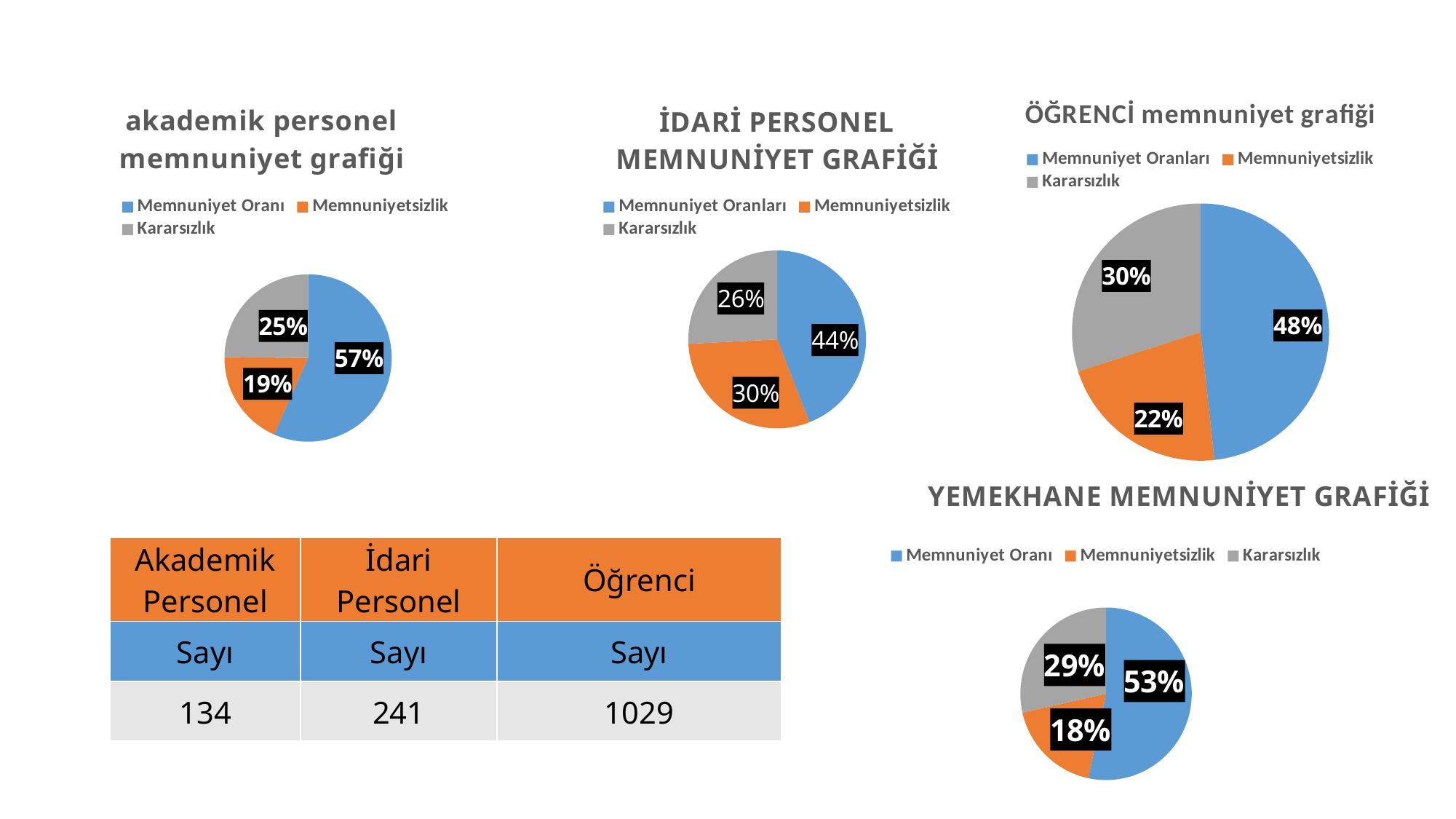
In the 'akademik personel memnuniyet grafiği' chart, what is the value for Memnuniyetsizlik? 19% In the 'ÖĞRENCİ memnuniyet grafiği' chart, which slice is the smallest? Memnuniyetsizlik In the 'YEMEKHANE MEMNUNİYET GRAFİĞİ' chart, what is the difference between Kararsızlık and Memnuniyetsizlik? 11% In the 'akademik personel memnuniyet grafiği' chart, what is the difference between Memnuniyet Oranı and Kararsızlık? 32% What kind of chart is the 'YEMEKHANE MEMNUNİYET GRAFİĞİ' chart? pie chart Is the Memnuniyet Oranları value in the 'İDARİ PERSONEL MEMNUNİYET GRAFİĞİ' chart larger or smaller than the Memnuniyet Oranları value in the 'ÖĞRENCİ memnuniyet grafiği' chart? smaller How many entries does the legend of the 'ÖĞRENCİ memnuniyet grafiği' chart list? 3 In the 'YEMEKHANE MEMNUNİYET GRAFİĞİ' chart, what is the value for Memnuniyet Oranı? 53% In the 'İDARİ PERSONEL MEMNUNİYET GRAFİĞİ' chart, which slice is the largest? Memnuniyet Oranları In the 'akademik personel memnuniyet grafiği' chart, what is the value for Memnuniyet Oranı? 57% In the 'ÖĞRENCİ memnuniyet grafiği' chart, what is the value for Memnuniyetsizlik? 22% In the 'İDARİ PERSONEL MEMNUNİYET GRAFİĞİ' chart, what is the value for Kararsızlık? 26%